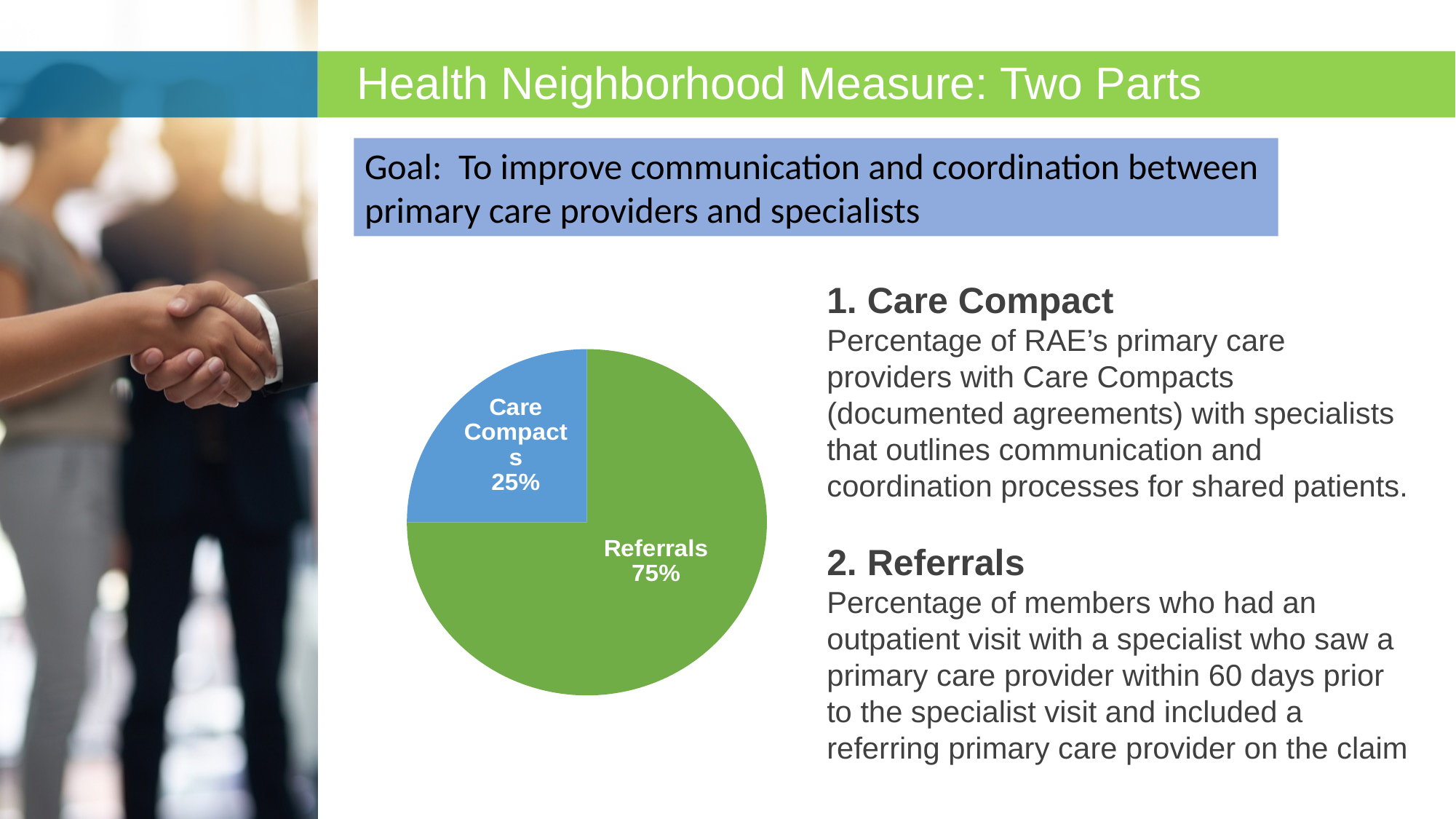
What kind of chart is shown on the slide? pie chart What colour is the Referrals slice of the pie? green Which is larger, the Care Compacts slice or the Referrals slice? Referrals How many slices does the pie chart have? 2 What colour is the Care Compacts slice of the pie? blue Which slice of the pie is the smallest? Care Compacts What is the difference in percentage points between the Referrals slice and the Care Compacts slice? 50 What share of the pie does Care Compacts take? 25% What share of the pie does Referrals take? 75% Which slice of the pie is the largest? Referrals